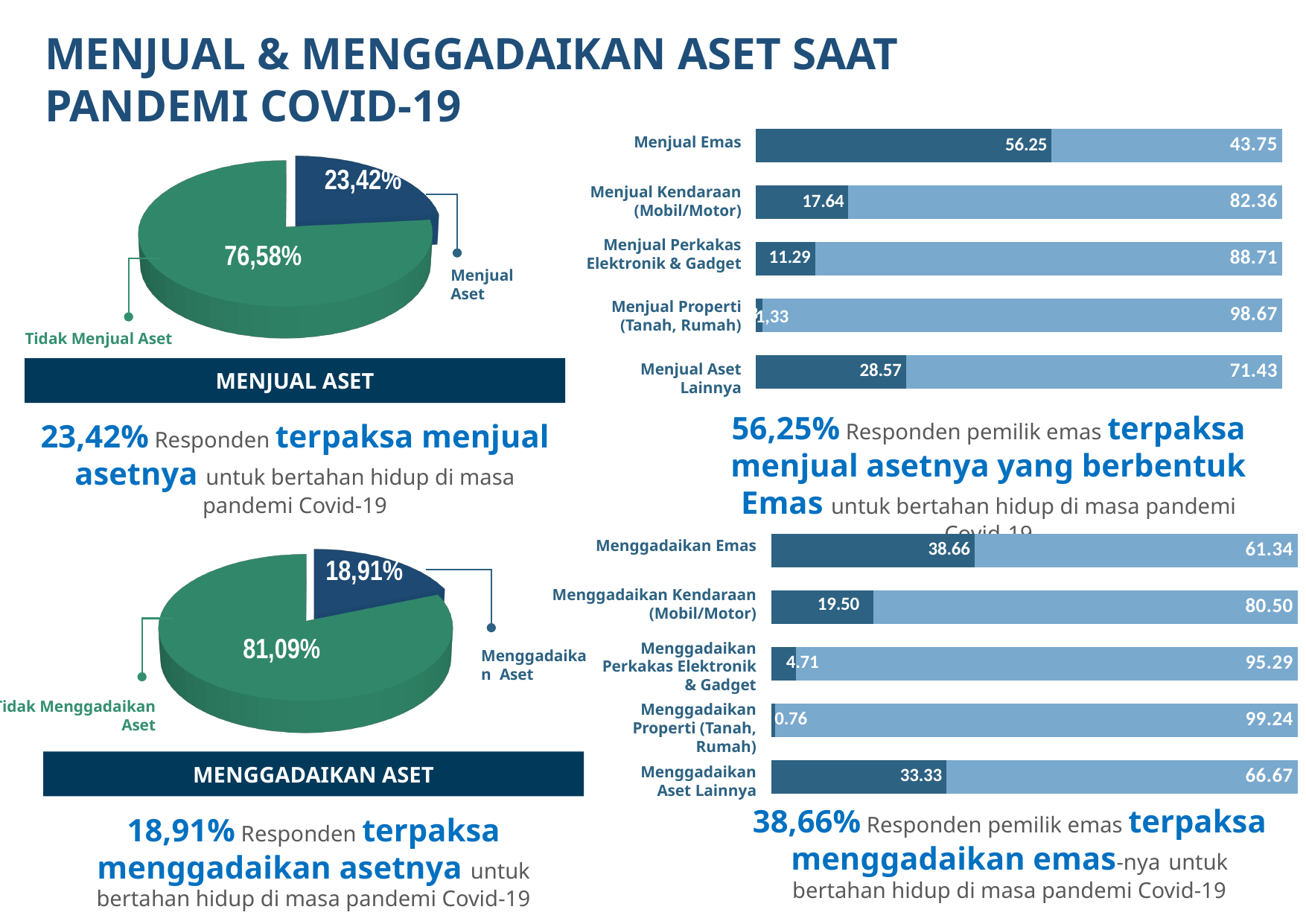
In the bottom-right bar chart, what is the dark blue value for Menggadaikan Aset Lainnya? 33.33 In the bottom-left pie chart (Menggadaikan Aset), what share is labelled for Menggadaikan Aset? 18,91% In the top-right bar chart, which category has the highest dark blue value? Menjual Emas In the top-left pie chart (Menjual Aset), what share is labelled for Tidak Menjual Aset? 76,58% In the bottom-right bar chart, what is the difference between the dark blue values for Menggadaikan Emas and Menggadaikan Kendaraan (Mobil/Motor)? 19.16 In the bottom-right bar chart, which category has the lowest dark blue value? Menggadaikan Properti (Tanah, Rumah) What type of chart is shown at the top left of the slide? Pie chart In the top-right bar chart, how many categories are shown? 5 In the bottom-left pie chart (Menggadaikan Aset), which slice is larger: Menggadaikan Aset or Tidak Menggadaikan Aset? Tidak Menggadaikan Aset In the top-left pie chart (Menjual Aset), what share is labelled for Menjual Aset? 23,42% In the top-right bar chart, what is the light blue value for Menjual Kendaraan (Mobil/Motor)? 82.36 In the top-right bar chart, what is the dark blue value for Menjual Emas? 56.25